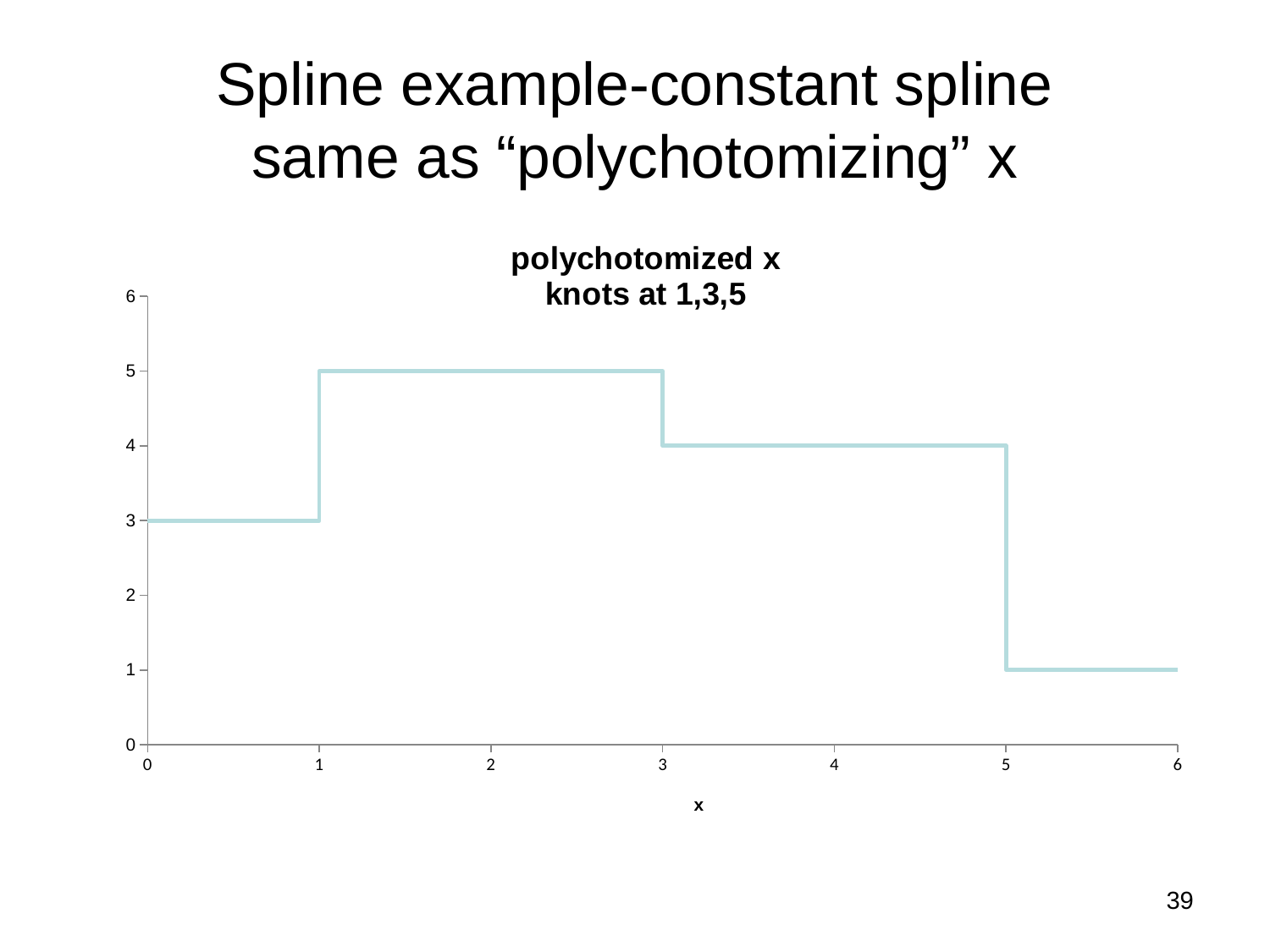
How many constant segments (steps) does the function have? 4 Which is larger: the value on the interval 0 to 1 or the value on the interval 3 to 5? 3 to 5 What is the title of the chart? polychotomized x knots at 1,3,5 What is the value of the step function between x = 1 and x = 3? 5 Over which interval of x does the step function have its lowest value? 5 to 6 What is the difference between the value on the interval 1 to 3 and the value on the interval 5 to 6? 4 What is the label of the x axis? x What is the value of the step function between x = 5 and x = 6? 1 What is the value of the step function between x = 3 and x = 5? 4 Over which interval of x does the step function reach its highest value? 1 to 3 Does the value of the function rise or fall from the interval 3 to 5 to the interval 5 to 6? fall What is the value of the step function between x = 0 and x = 1? 3